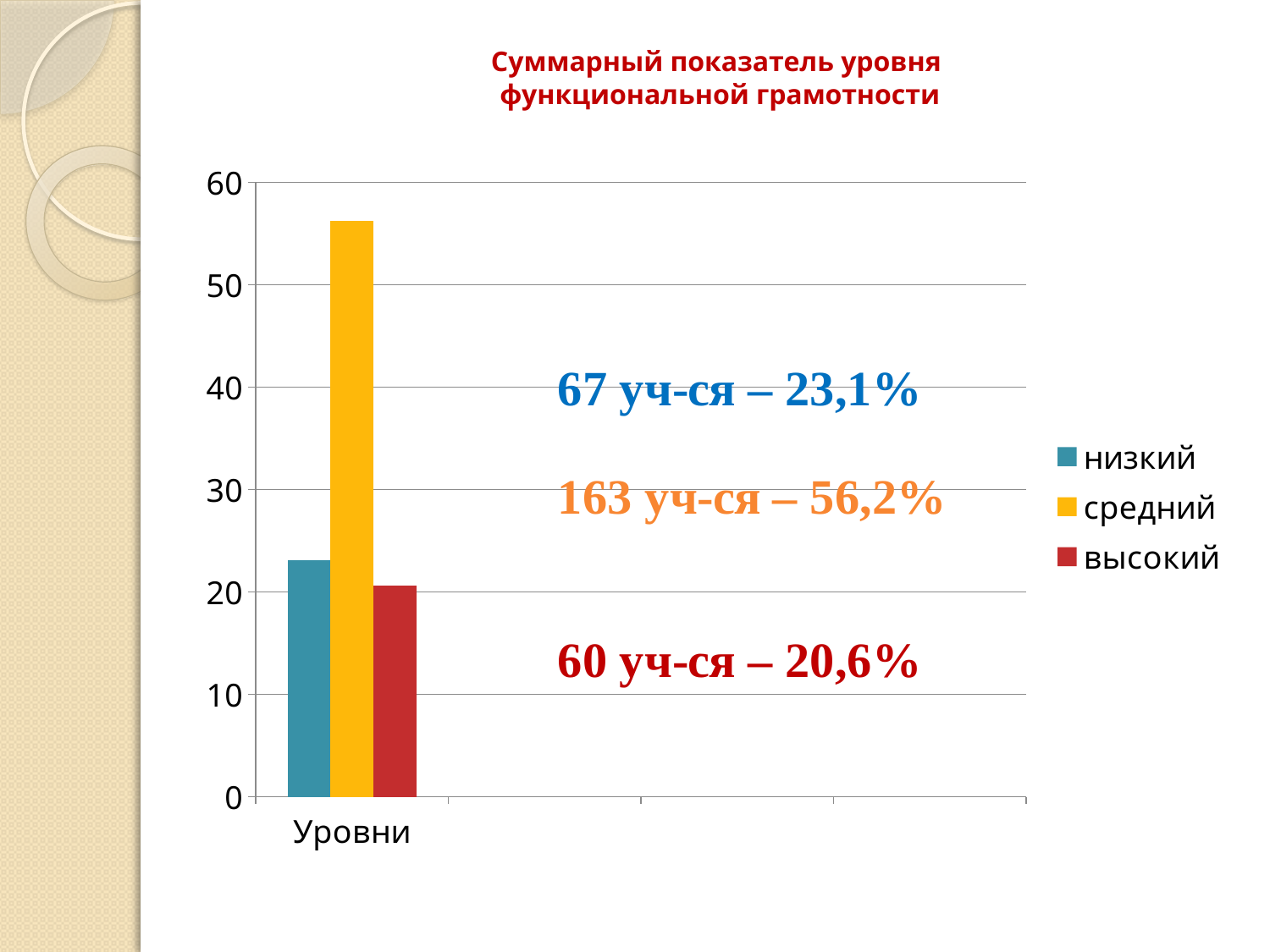
Which series has the lowest bar? высокий What kind of chart is shown on the slide? bar chart Which series has the highest bar? средний What is the title of the chart? Суммарный показатель уровня функциональной грамотности How many series does the legend list? 3 Which bar is taller, низкий or высокий? низкий According to the annotation on the slide, what percentage corresponds to the средний level? 56,2% Is the value for средний greater or less than 50? greater How many categories are shown on the x axis? 1 Is the value for высокий greater or less than 30? less Is the value for низкий greater or less than 20? greater According to the annotation on the slide, how many students (уч-ся) are at the высокий level? 60